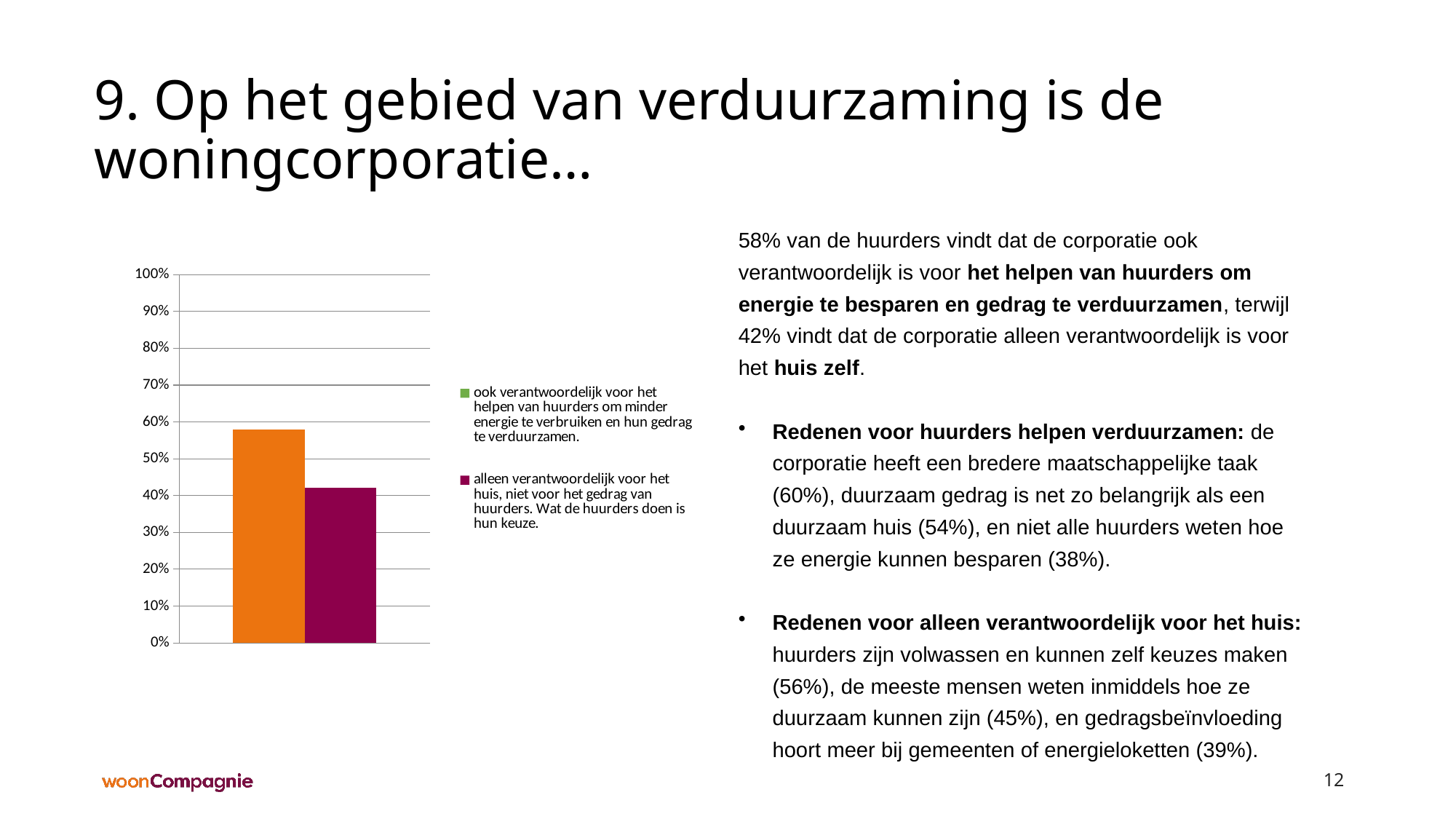
What is the highest value shown on the chart's vertical axis? 100% How many series does the chart's legend list? 2 Is the value of the purple bar greater or less than 30%? greater Which bar is taller, the orange bar or the purple bar? the orange bar Is the value of the purple bar greater or less than 50%? less How many bars are plotted in the chart? 2 Is the value of the orange bar greater or less than 50%? greater What kind of chart is shown on the slide? bar chart What is the interval between tick marks on the chart's vertical axis? 10%